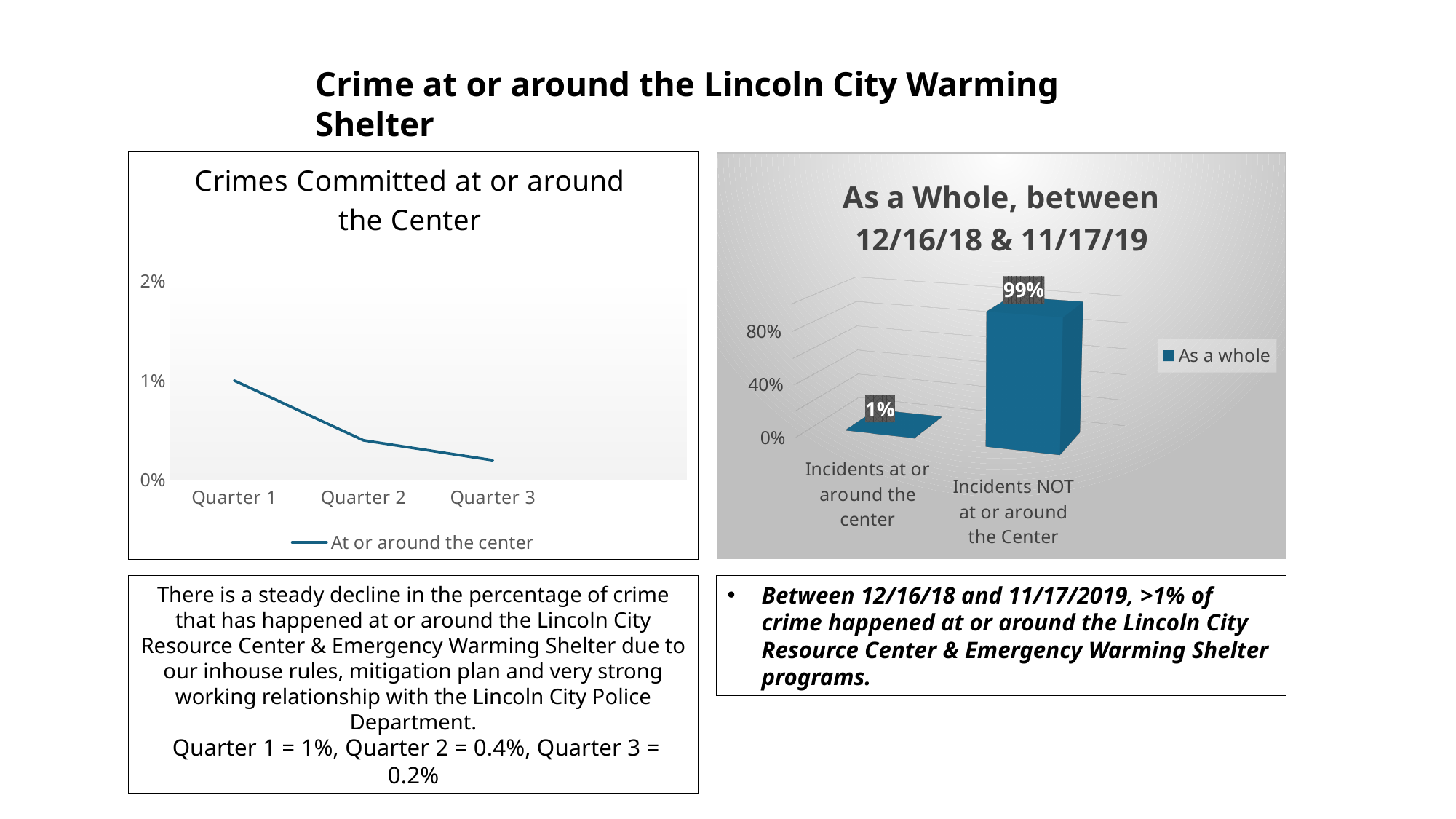
In the 'Crimes Committed at or around the Center' chart, do the values rise or fall from Quarter 1 to Quarter 3? fall What type of chart is the 'Crimes Committed at or around the Center' chart? line chart In the 'As a Whole, between 12/16/18 & 11/17/19' chart, what is the value for 'Incidents NOT at or around the Center'? 99% In the 'Crimes Committed at or around the Center' chart, how many quarters are plotted? 3 In the 'As a Whole, between 12/16/18 & 11/17/19' chart, what is the value for 'Incidents at or around the center'? 1% In the 'Crimes Committed at or around the Center' chart, what series name does the legend show? At or around the center In the 'Crimes Committed at or around the Center' chart, what is the value for Quarter 1? 1% In the 'Crimes Committed at or around the Center' chart, which quarter has the lowest value? Quarter 3 In the 'Crimes Committed at or around the Center' chart, which quarter has the highest value? Quarter 1 In the 'As a Whole, between 12/16/18 & 11/17/19' chart, what is the difference between 'Incidents NOT at or around the Center' and 'Incidents at or around the center'? 98% What type of chart is the 'As a Whole, between 12/16/18 & 11/17/19' chart? bar chart In the 'Crimes Committed at or around the Center' chart, is the value for Quarter 2 greater or less than 1%? less